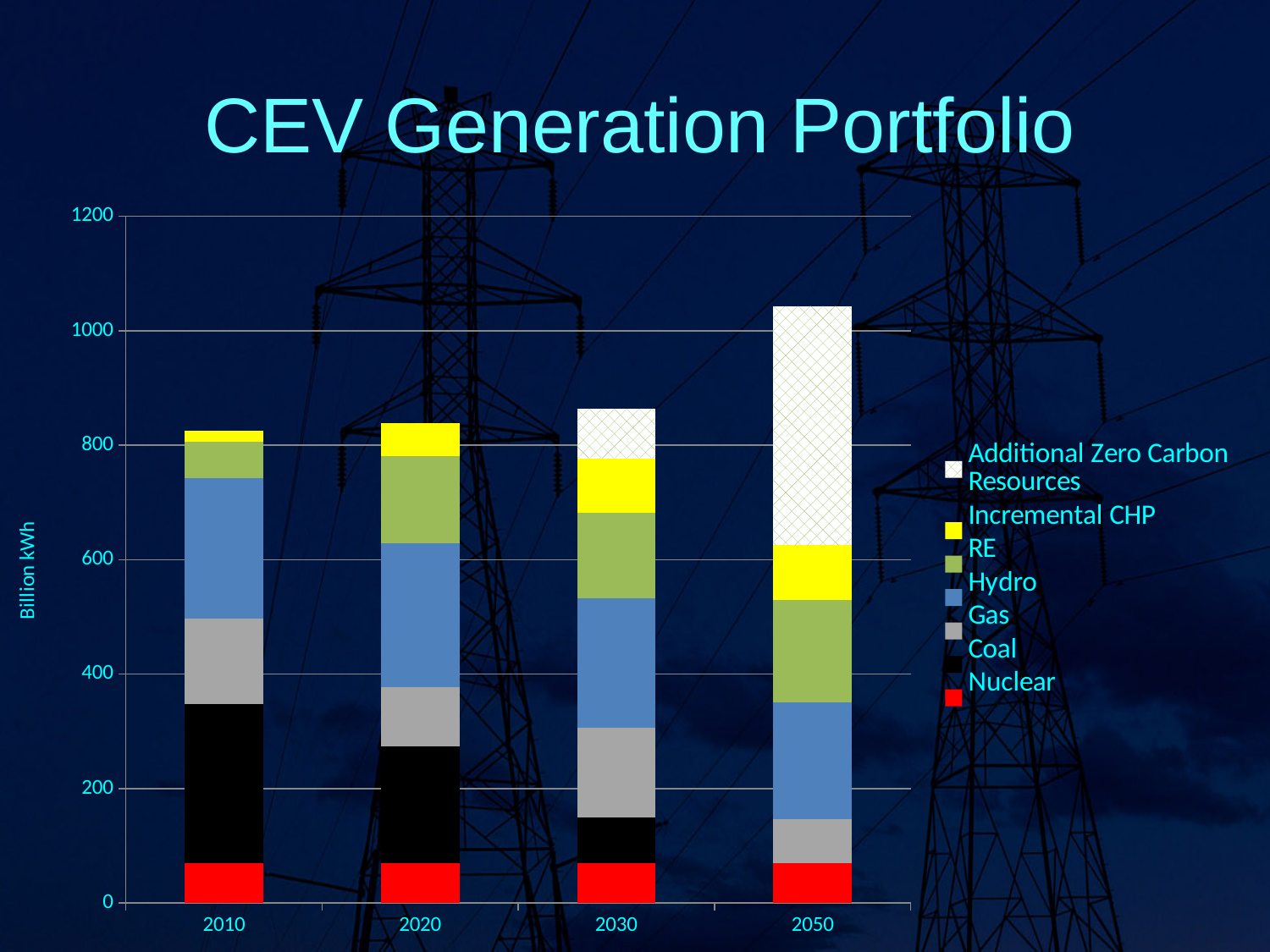
Is the total for 2030 greater or less than 1000? less Do the stacked bar totals rise or fall from 2010 to 2050? rise Is the total for 2050 greater or less than 1000? greater How many years are shown on the x axis of the chart? 4 What is the title of the chart? CEV Generation Portfolio Is the total for 2020 greater or less than 1000? less How many series does the chart's legend list? 7 What kind of chart is shown on the slide? Stacked bar chart What is the label on the vertical axis of the chart? Billion kWh Which year has the tallest stacked bar? 2050 Which is larger, the total for 2010 or the total for 2050? 2050